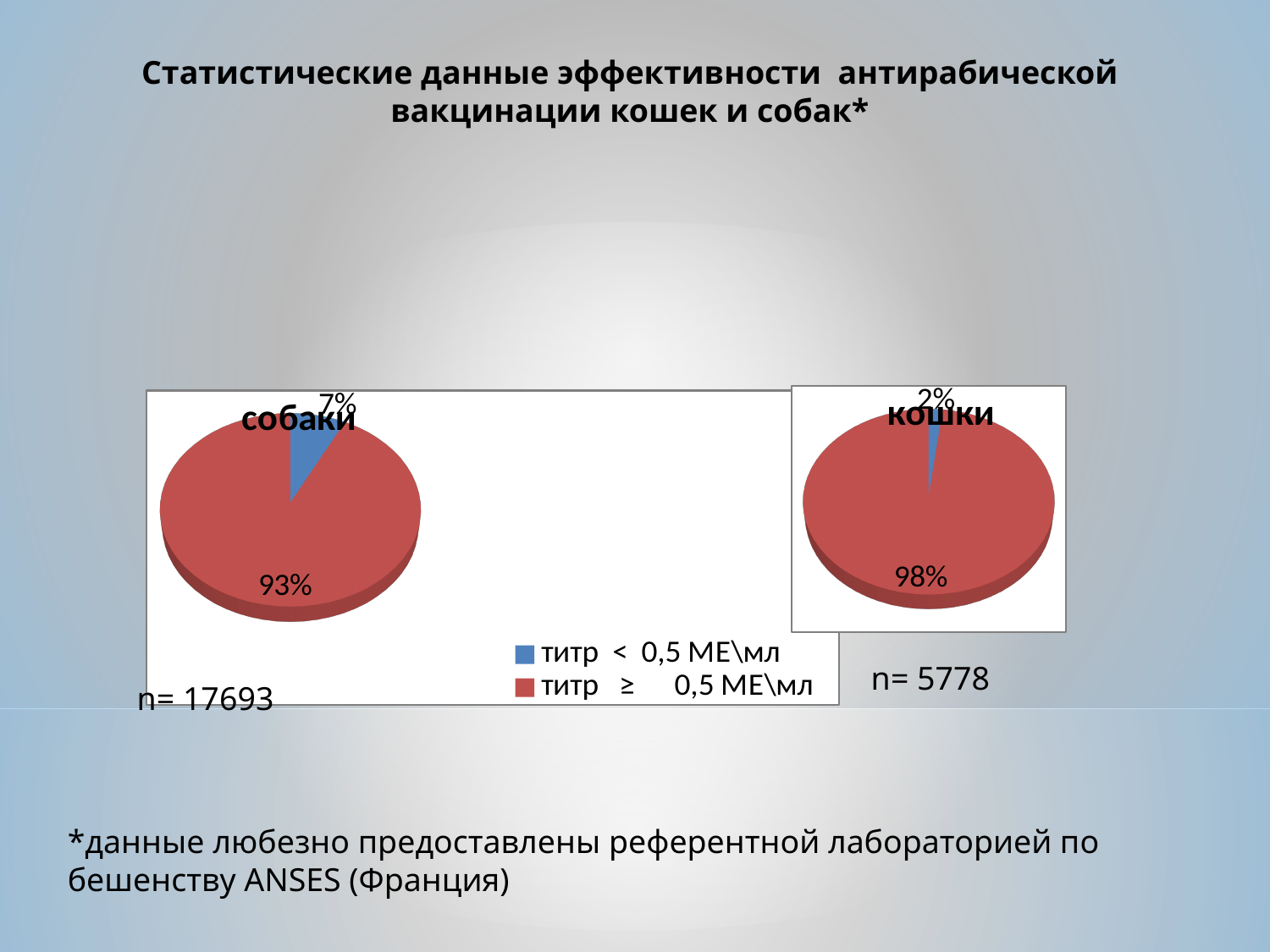
In the "собаки" chart, what share of the pie is labelled for the red slice (титр ≥ 0,5 МЕ\мл)? 93% What colour is the slice for титр < 0,5 МЕ\мл in the pie charts? blue In the "кошки" chart, which slice is the smallest? титр < 0,5 МЕ\мл What kind of chart is the "собаки" chart? pie chart How many entries does the legend list? 2 What is the difference between the share of титр ≥ 0,5 МЕ\мл in the "кошки" chart and in the "собаки" chart? 5% Which is larger: the share of титр < 0,5 МЕ\мл in the "собаки" chart or in the "кошки" chart? собаки In the "кошки" chart, what share of the pie is labelled for the blue slice (титр < 0,5 МЕ\мл)? 2% In the "собаки" chart, what share of the pie is labelled for the blue slice (титр < 0,5 МЕ\мл)? 7% How many slices does the "кошки" pie chart have? 2 In the "собаки" chart, which slice is the largest? титр ≥ 0,5 МЕ\мл